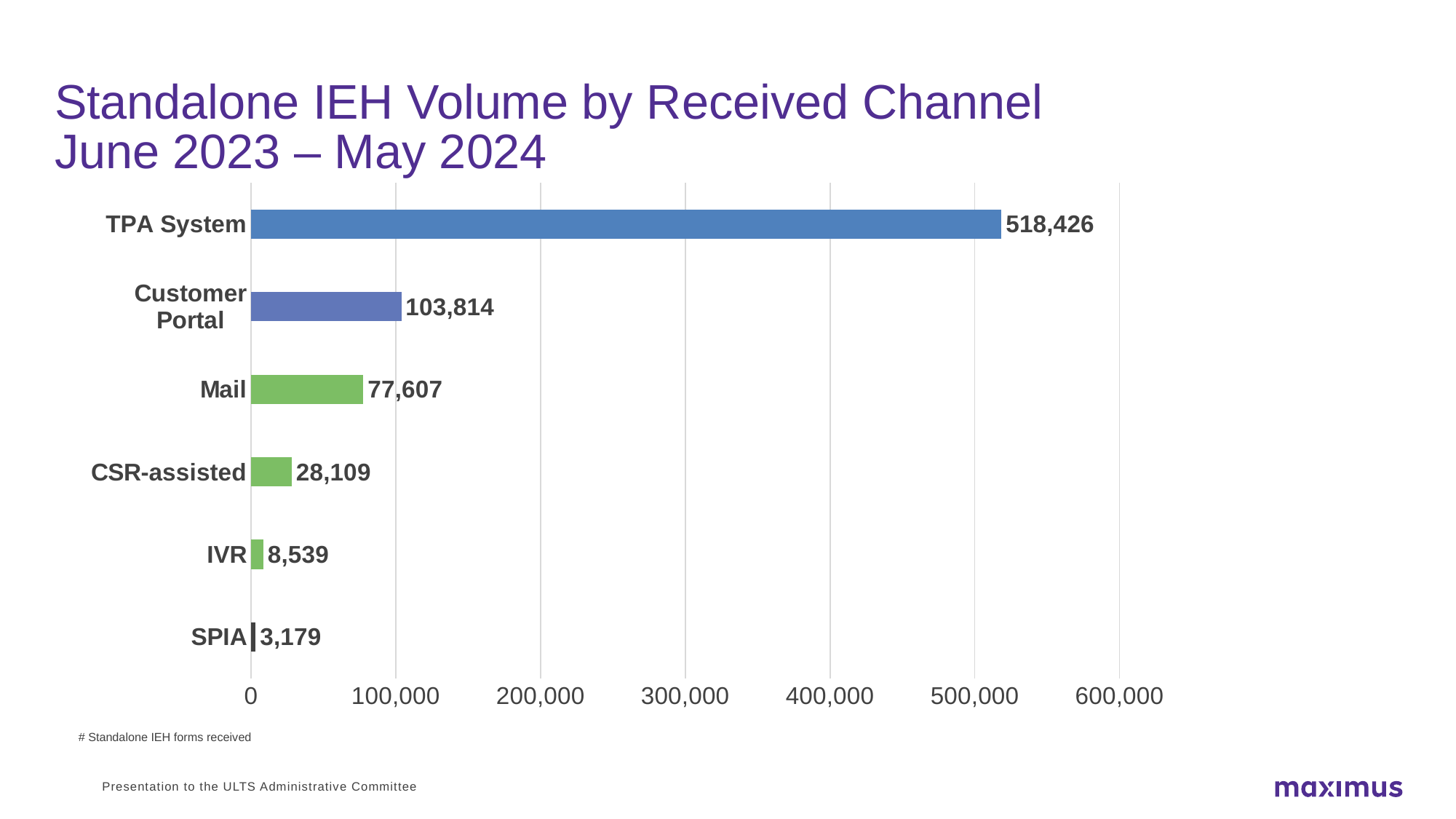
What is the value for IVR? 8,539 What is the difference between the Customer Portal and Mail values? 26,207 Which channel has the lowest volume? SPIA Is the value for TPA System greater or less than 500,000? greater What is the value for Mail? 77,607 What kind of chart is shown on the slide? bar chart Which channel has the highest volume? TPA System What is the value for TPA System? 518,426 Which is larger, CSR-assisted or IVR? CSR-assisted What is the title of the chart? Standalone IEH Volume by Received Channel June 2023 – May 2024 What is the value for Customer Portal? 103,814 How many channels are shown in the chart? 6